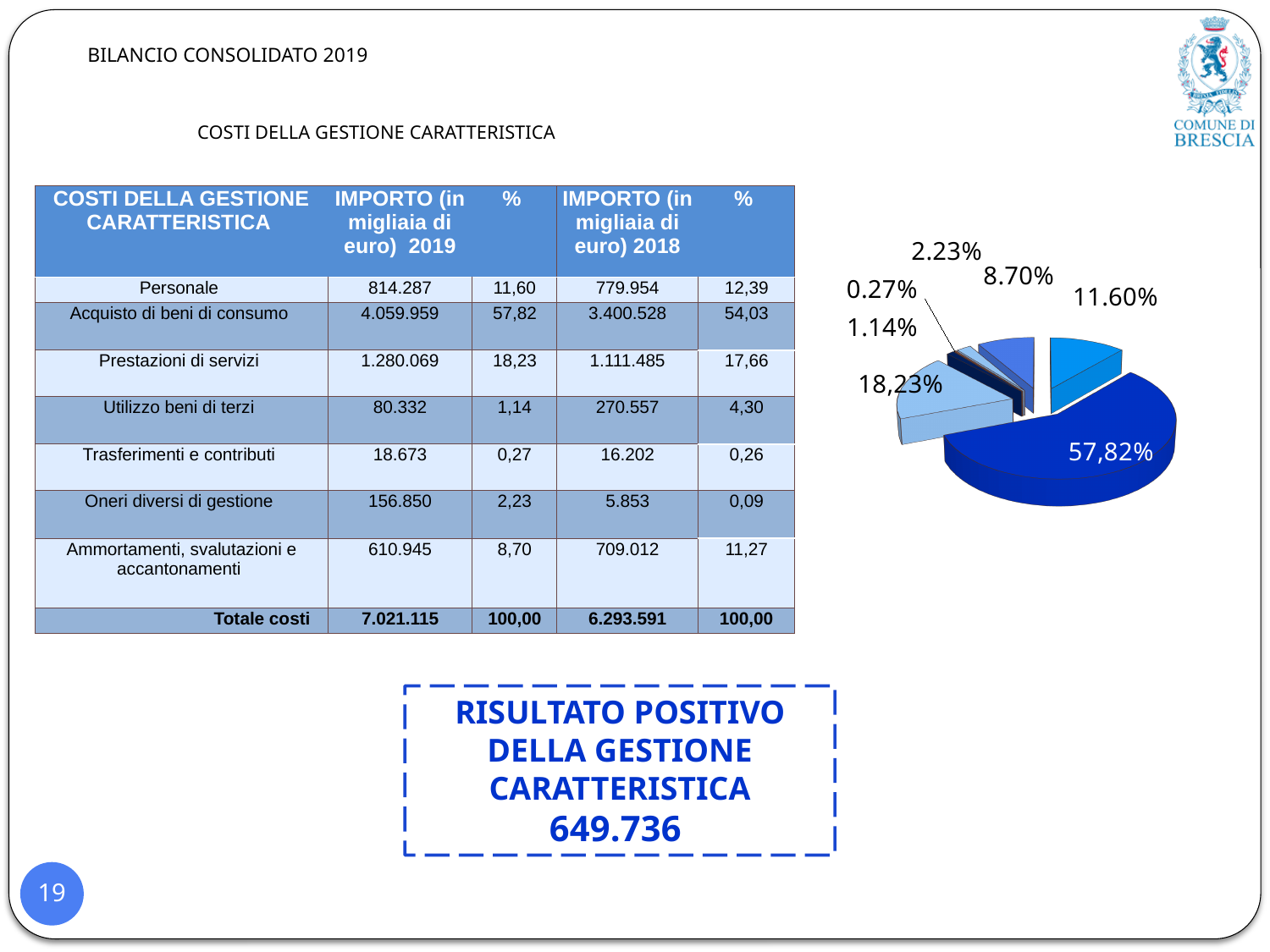
Is the largest slice of the pie chart greater or less than 50%? greater What is the difference between the slices labelled 8.70% and 2.23% in the pie chart? 6.47% What is the data label of the largest slice in the pie chart? 57,82% What kind of chart is shown on the slide? pie chart According to the table on the slide, which cost category does the 18.23% slice of the pie chart correspond to? Prestazioni di servizi Which slice is larger in the pie chart, the one labelled 18.23% or the one labelled 11.60%? 18.23% Does the pie chart display a legend? No What share of the pie does the largest slice represent? 57,82% How many slices does the pie chart have? 7 According to the table on the slide, which cost category does the 57,82% slice of the pie chart correspond to? Acquisto di beni di consumo What is the data label of the smallest slice in the pie chart? 0.27% What is the difference between the slices labelled 18.23% and 11.60% in the pie chart? 6.63%